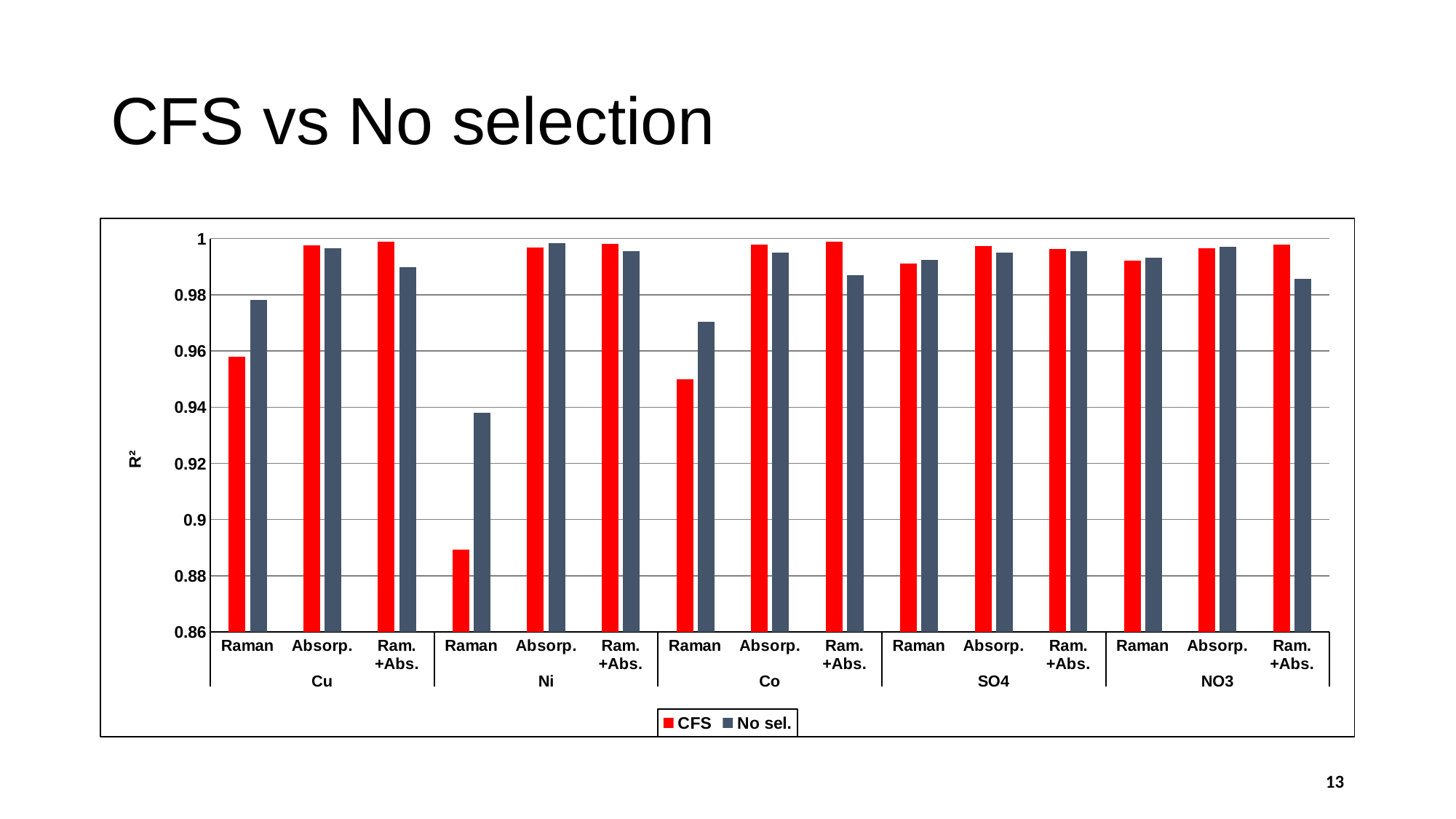
Which bar has the lowest R² value in the chart? CFS for Raman under Ni What is the label on the vertical axis? R² Is the No sel. value for Raman under Ni greater or less than 0.92? greater How many series does the legend list? 2 For Raman under Co, which is larger: CFS or No sel.? No sel. For Ram.+Abs. under Co, which is larger: CFS or No sel.? CFS Is the CFS value for Raman under Co greater or less than 0.96? less For Raman under Cu, which is larger: CFS or No sel.? No sel. What kind of chart is shown on the slide? bar chart How many analyte groups (Cu, Ni, etc.) are shown along the x axis? 5 Is the CFS value for Raman under Ni greater or less than 0.9? less What are the two series named in the legend? CFS and No sel.